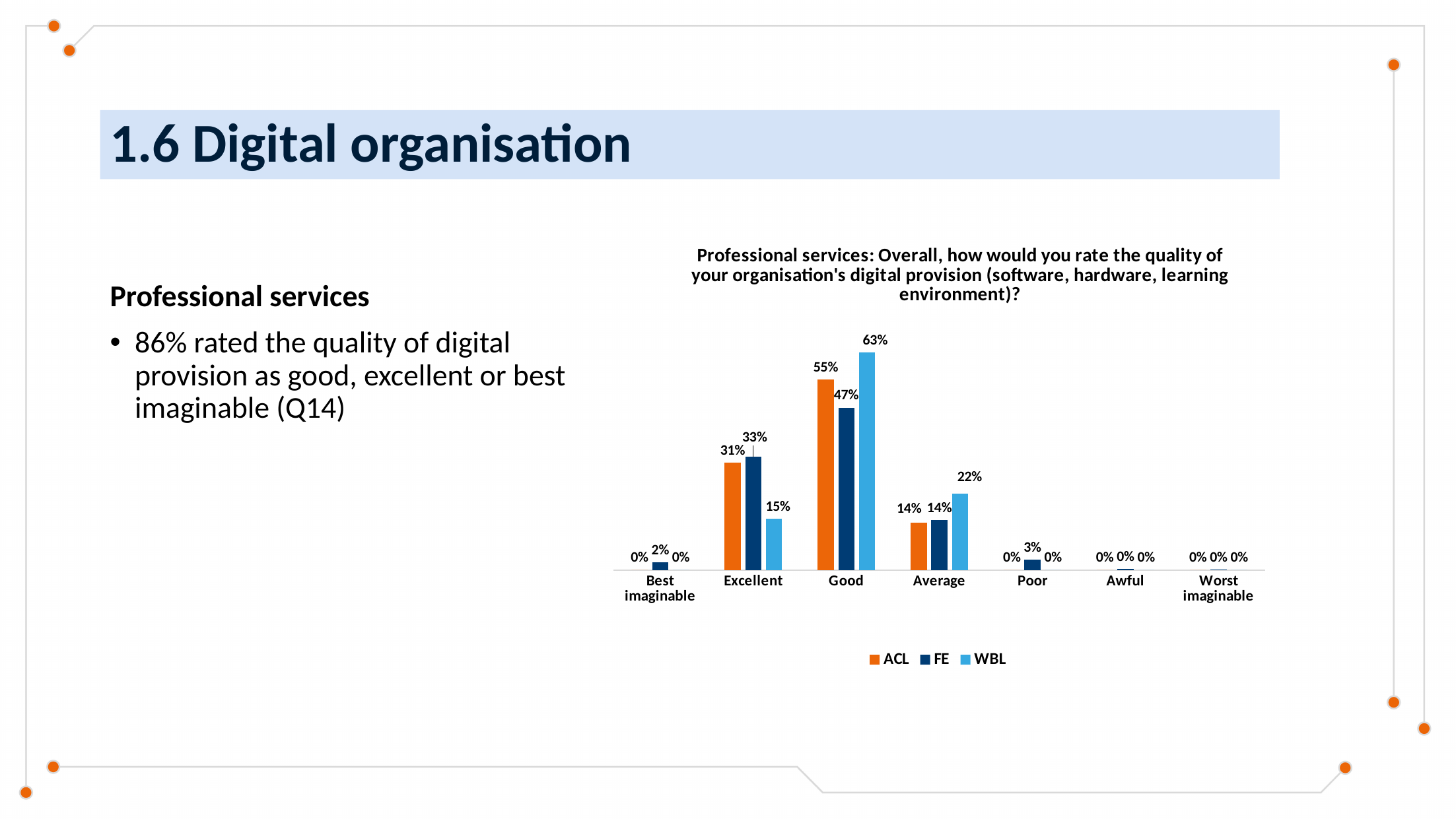
What is the ACL value for the Excellent category? 31% Which series is shown in orange in the legend? ACL What type of chart is shown on the slide? bar chart How many rating categories are shown on the x axis? 7 Which series has the lowest value in the Excellent category? WBL Which category has the highest value for the ACL series? Good What is the FE value for the Poor category? 3% In the Average category, is the WBL value larger or smaller than the ACL value? larger What percentage of WBL respondents rated their organisation's digital provision as Good? 63% How many series does the legend list? 3 What is the difference between the WBL and FE values for Good? 16% What is the difference between the ACL and WBL values for Excellent? 16%